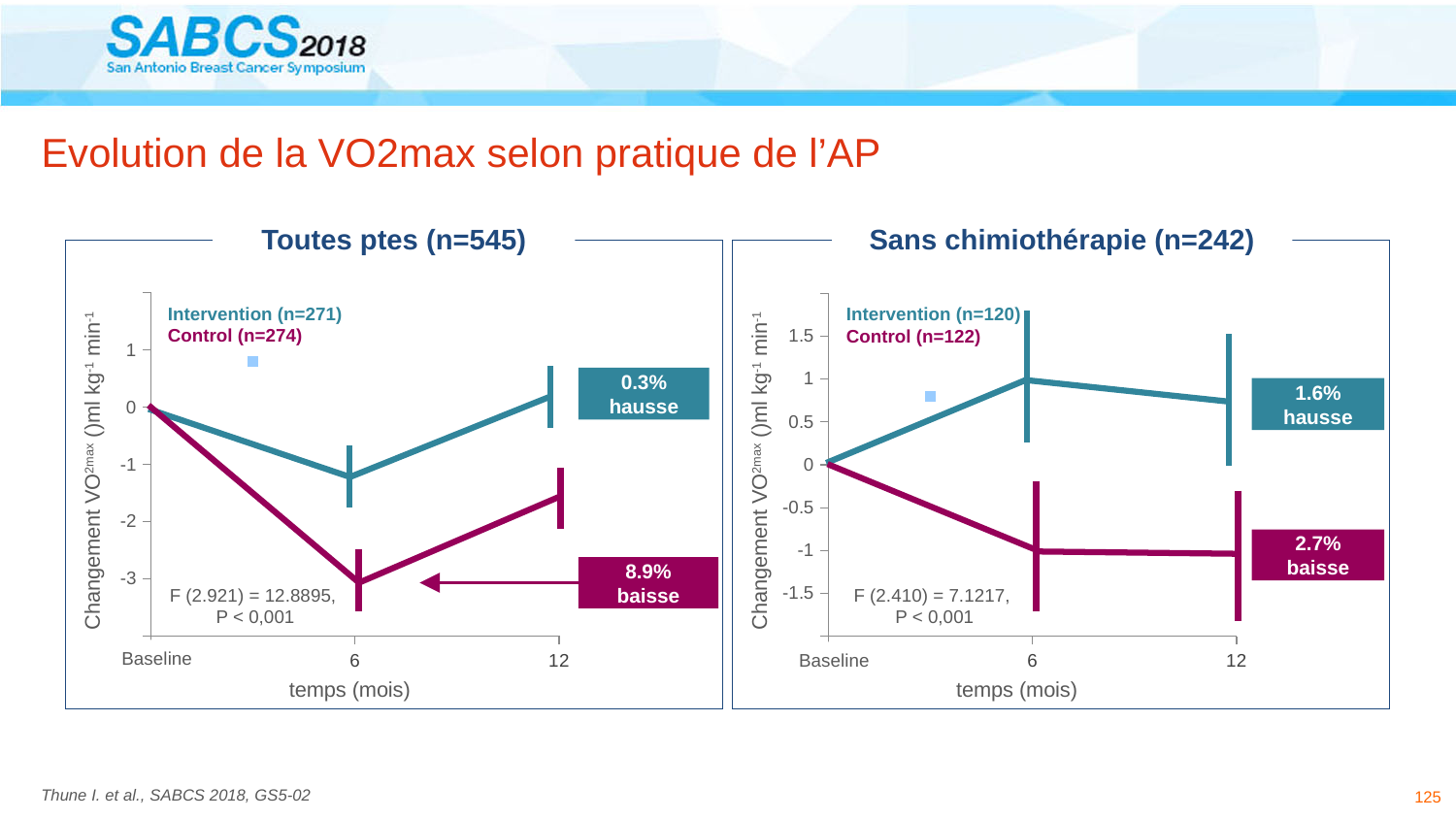
In the 'Sans chimiothérapie (n=242)' chart, is the Intervention value at 6 months greater or less than 0.5? greater In the 'Toutes ptes (n=545)' chart, is the Intervention value at 6 months greater or less than -2? greater In the 'Toutes ptes (n=545)' chart, does the Control line rise or fall from Baseline to 6 months? fall What kind of chart is the 'Toutes ptes (n=545)' chart? line chart In the 'Toutes ptes (n=545)' chart, what percentage change is annotated for the Intervention group at 12 months? 0.3% hausse In the 'Sans chimiothérapie (n=242)' chart, how many time points are plotted on the x axis? 3 In the 'Toutes ptes (n=545)' chart, how many series does the legend list? 2 In the 'Sans chimiothérapie (n=242)' chart, what percentage change is annotated for the Intervention group? 1.6% hausse In the 'Toutes ptes (n=545)' chart, is the Control value at 6 months greater or less than -2? less In the 'Sans chimiothérapie (n=242)' chart, which group has the higher value at 12 months, Intervention or Control? Intervention In the 'Sans chimiothérapie (n=242)' chart, what percentage change is annotated for the Control group? 2.7% baisse In the 'Toutes ptes (n=545)' chart, what percentage change is annotated for the Control group? 8.9% baisse